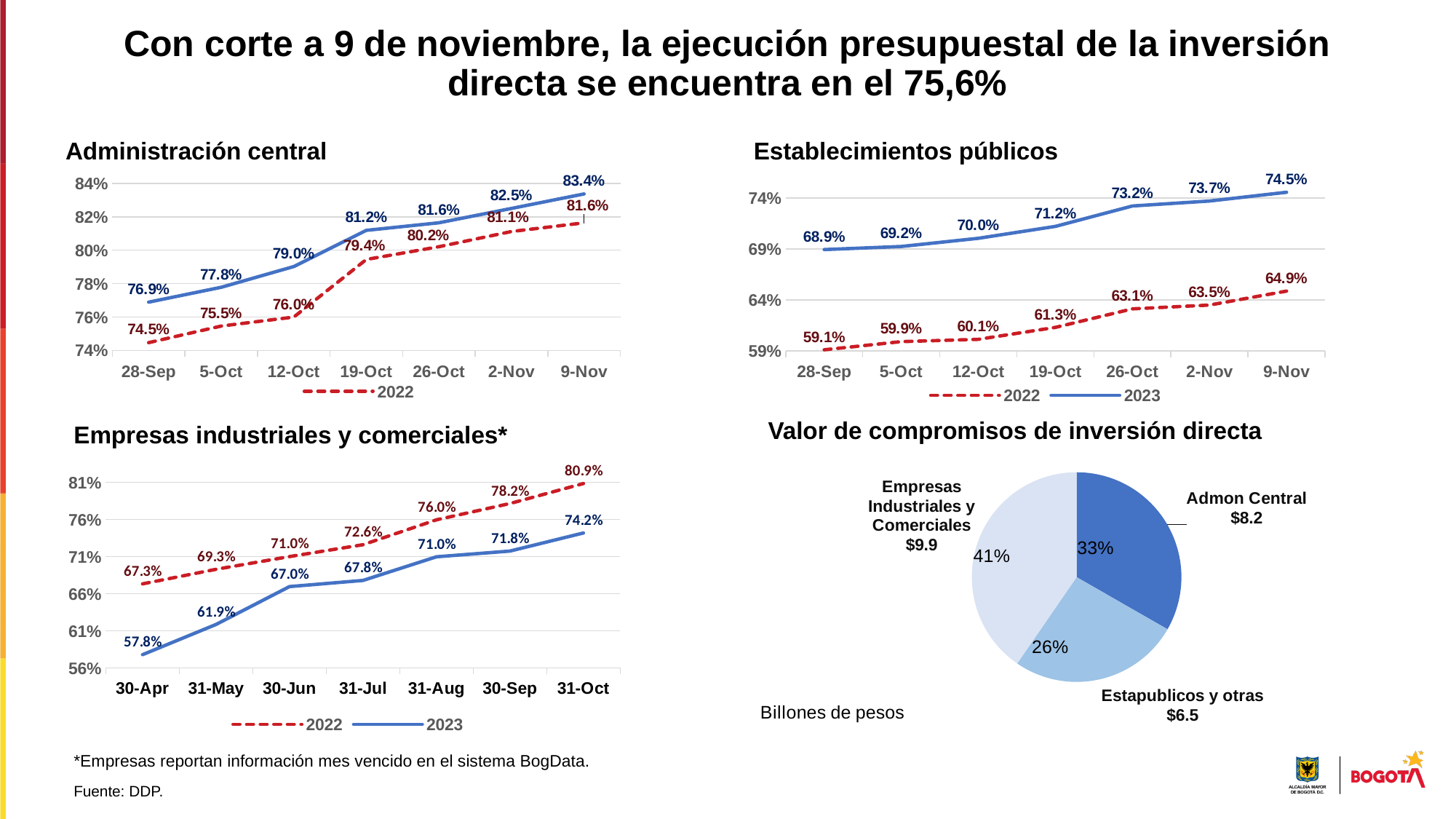
In the Empresas industriales y comerciales chart, what is the highest 2022 value shown? 80.9% In the Empresas industriales y comerciales chart, how many dates are shown on the x axis? 7 What kind of chart is Valor de compromisos de inversión directa? pie chart In the Administración central chart, what is the 2023 value on 9-Nov? 83.4% In the Valor de compromisos de inversión directa pie chart, what share does Admon Central have? 33% In the Empresas industriales y comerciales chart, what is the 2023 value on 30-Apr? 57.8% In the Establecimientos públicos chart, which series has the higher value on 26-Oct, 2022 or 2023? 2023 In the Administración central chart, what is the 2022 value on 28-Sep? 74.5% In the Administración central chart, what is the difference between the 2023 and 2022 values on 19-Oct? 1.8 percentage points In the Establecimientos públicos chart, what is the 2022 value on 9-Nov? 64.9% In the Establecimientos públicos chart, how many series does the legend list? 2 In the Empresas industriales y comerciales chart, does the 2023 series rise or fall from 30-Apr to 31-Oct? rise